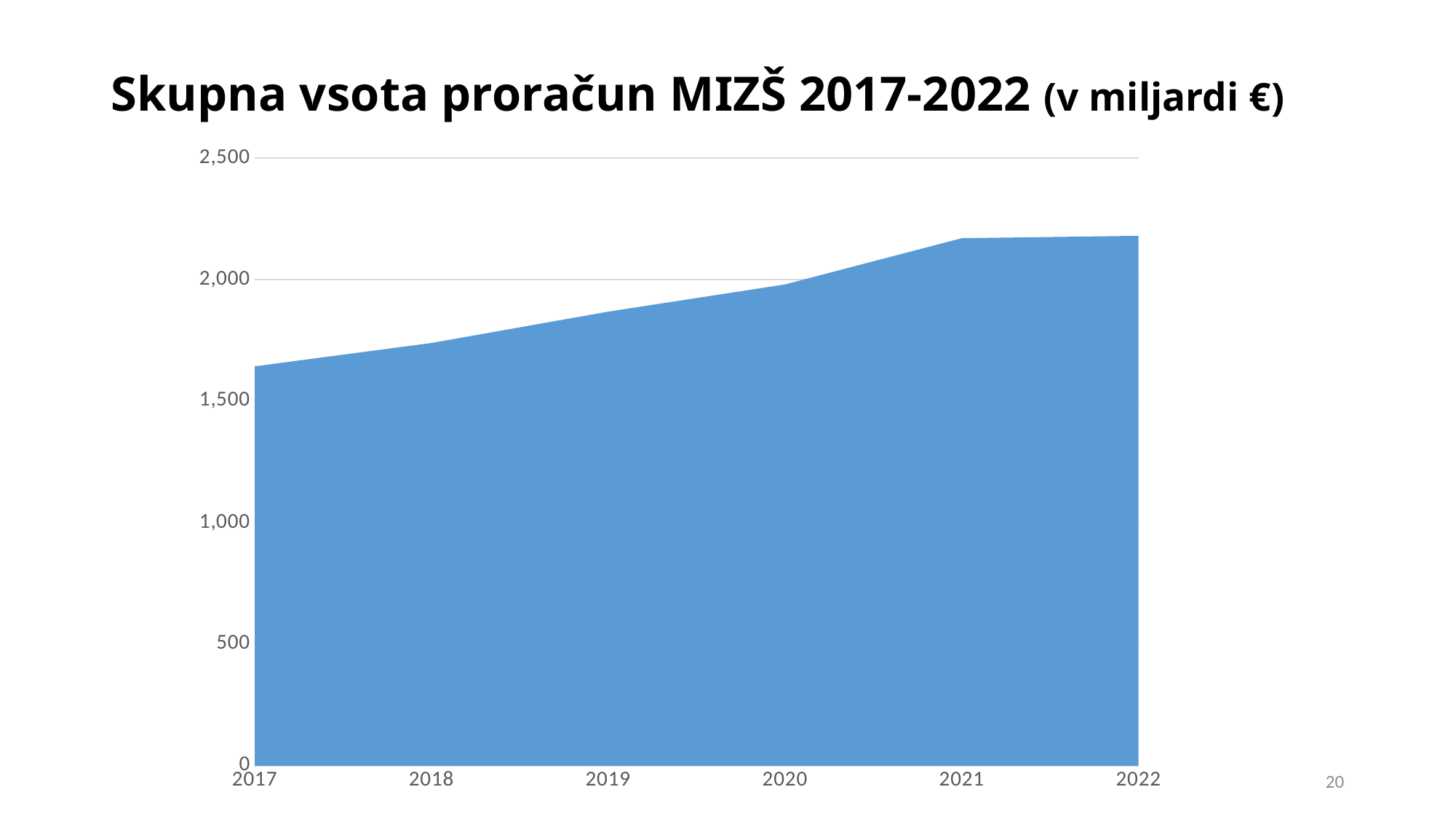
What kind of chart is shown on the slide? area chart Which is larger, the value for 2017 or the value for 2021? 2021 Is the value for 2021 greater or less than 2,000? greater Is the value for 2017 greater or less than 2,000? less Is the value for 2017 greater or less than 1,500? greater Which year has the lowest value? 2017 What is the title of the chart? Skupna vsota proračun MIZŠ 2017-2022 (v miljardi €) Which is larger, the value for 2018 or the value for 2020? 2020 How many years are plotted along the x axis? 6 Do the values rise or fall from 2017 to 2022? rise